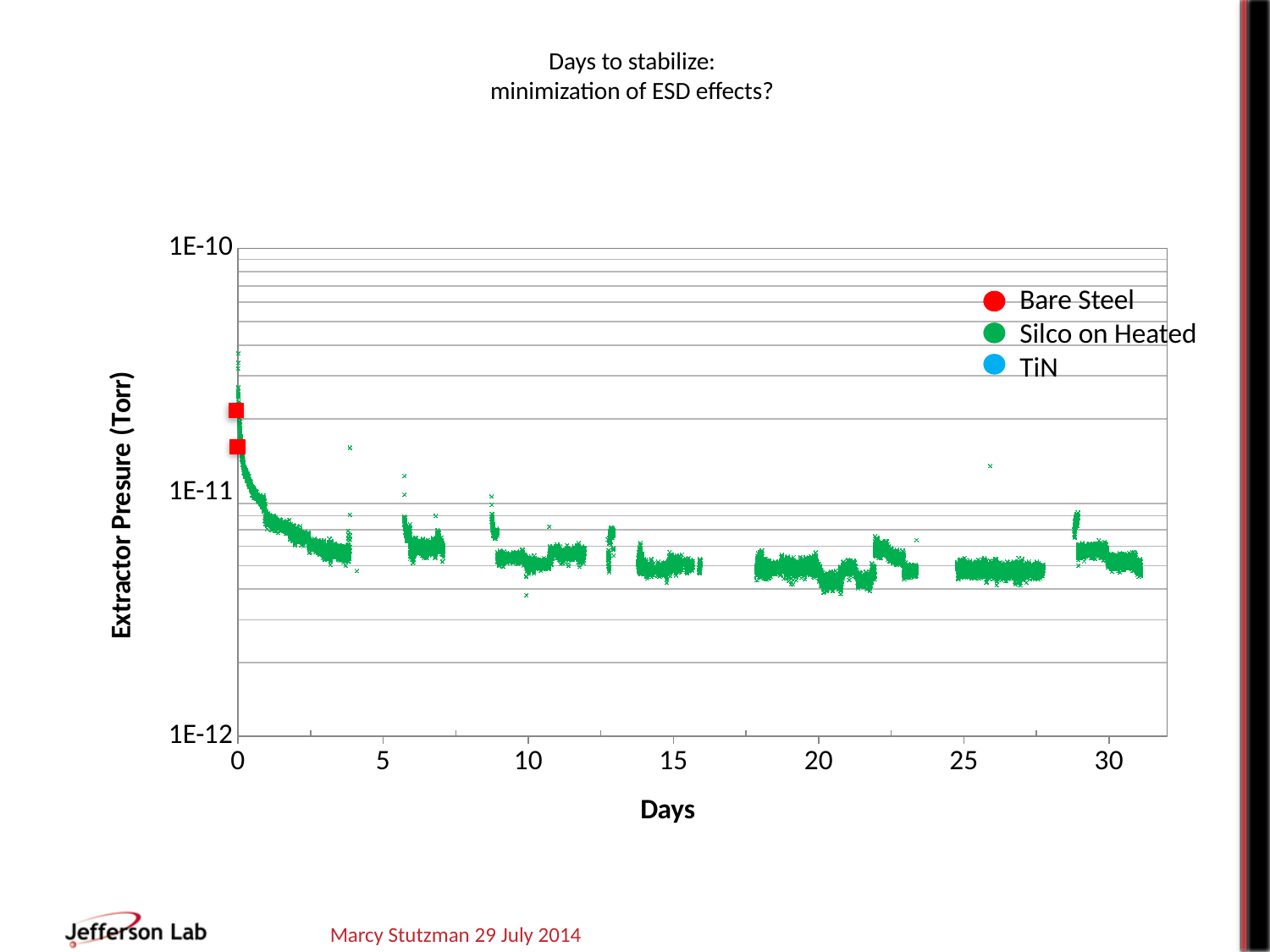
Is the Silco on Heated value at day 30 greater or less than 1E-11? less Is the Silco on Heated value at day 20 greater or less than 1E-12? greater How many series does the legend list? 3 Which series is plotted in green? Silco on Heated What is the title of the chart? Days to stabilize: minimization of ESD effects? What is the label of the y axis? Extractor Presure (Torr) Is the Silco on Heated value at day 10 greater or less than 1E-11? less What kind of chart is shown on the slide? Scatter chart Do the Silco on Heated values rise or fall as the days increase from 0 to 5? fall